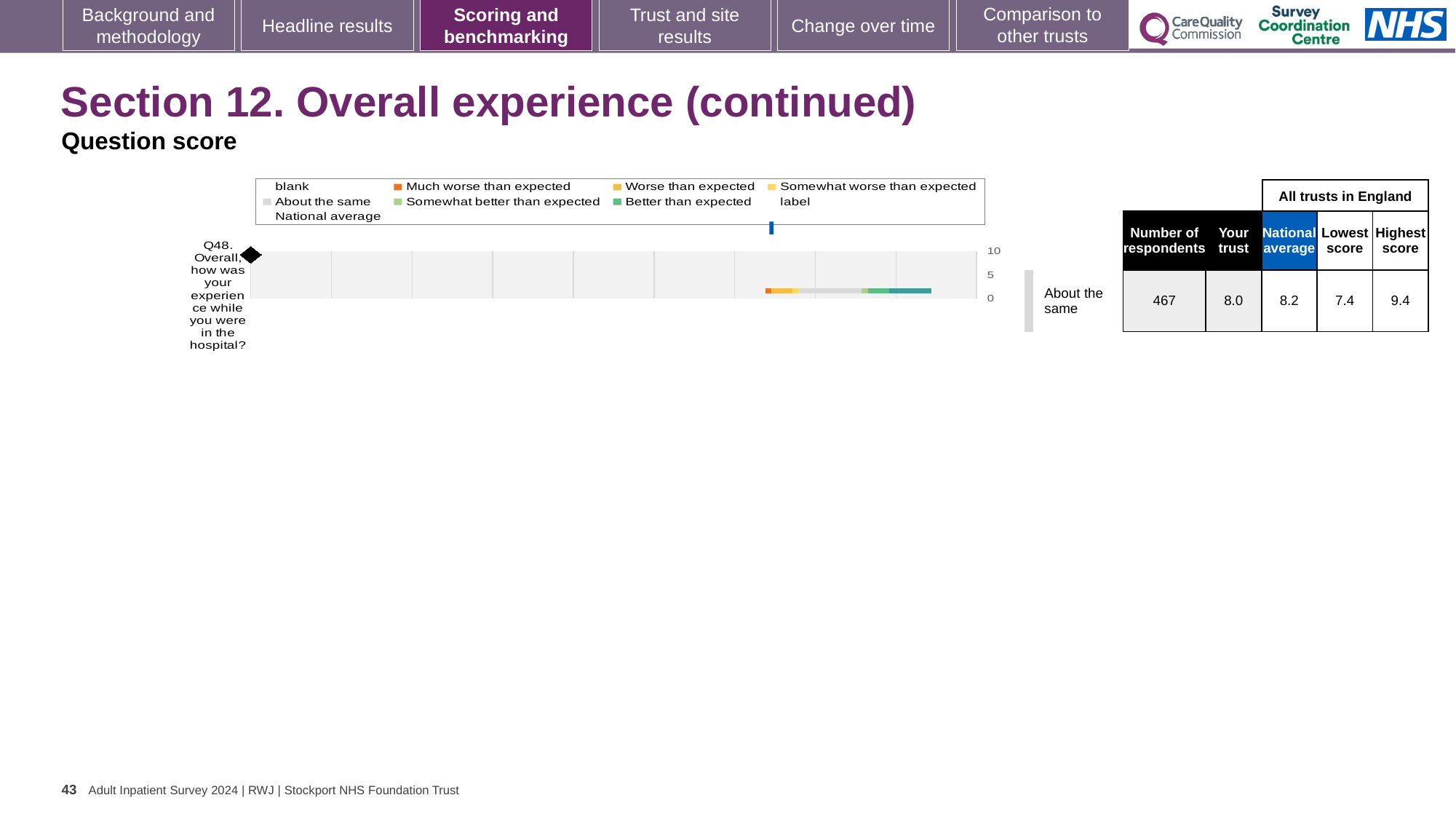
What is the difference between the highest and lowest scores among all trusts in England for Q48? 2.0 What is the lowest score among all trusts in England for Q48? 7.4 What is the national average score for Q48? 8.2 What is the 'Your trust' score for Q48? 8.0 How many entries does the chart legend list? 9 Which question is plotted in the chart? Q48. Overall, how was your experience while you were in the hospital? What is the highest value shown on the chart's score axis? 10 How many questions (categories) are plotted in the chart? 1 Which is larger for Q48: the trust's score or the national average? National average What kind of chart is shown on the slide? bar chart How many respondents answered Q48? 467 What is the highest score among all trusts in England for Q48? 9.4